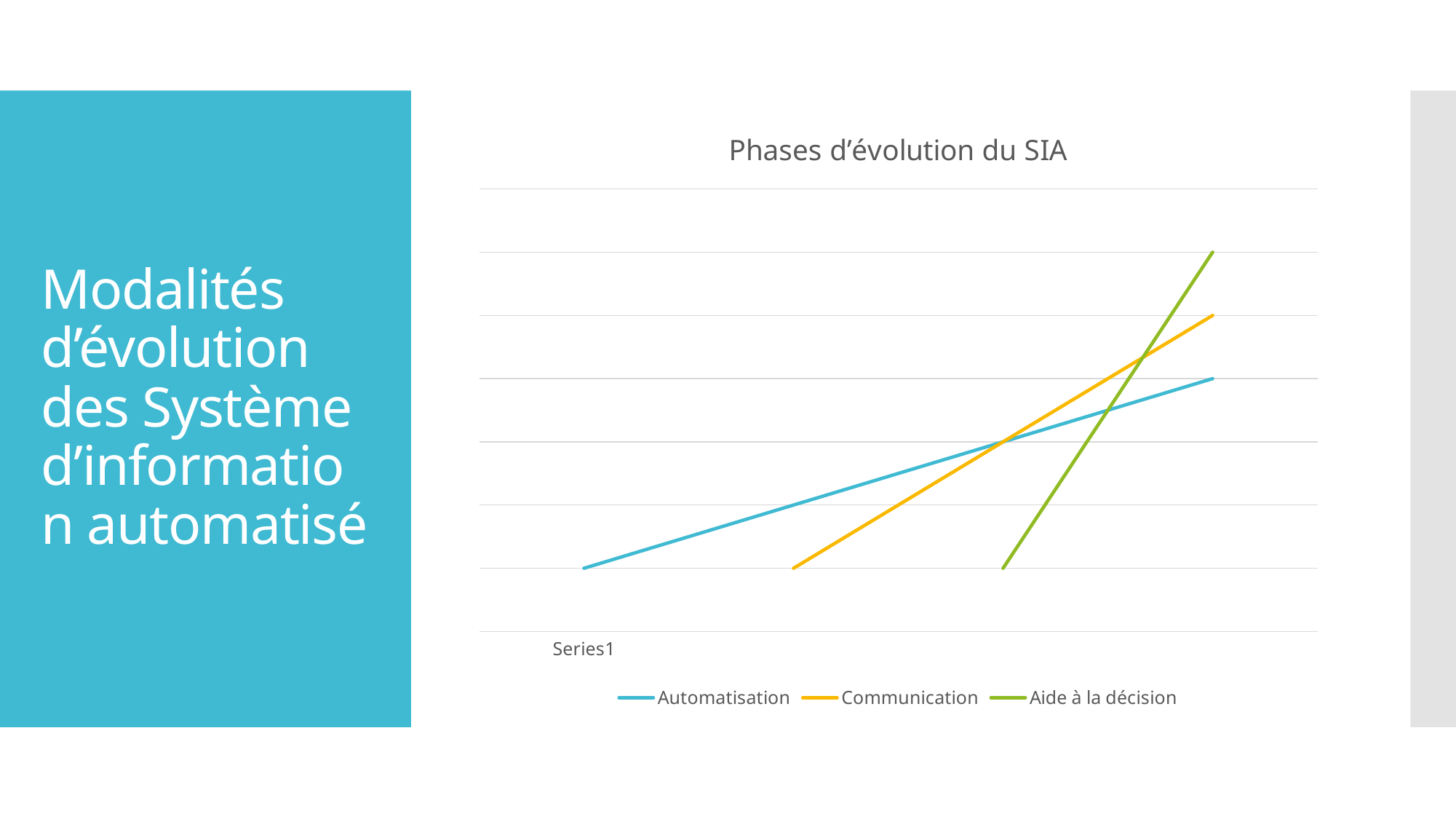
Which series is drawn in green? Aide à la décision Which series reaches the highest point on the chart? Aide à la décision Does the Aide à la décision line rise or fall from left to right? Rise Which series has the steepest line? Aide à la décision Which series ends at the lowest point on the right side of the chart? Automatisation Does the Automatisation line rise or fall from left to right? Rise Does the Communication line rise or fall from left to right? Rise How many series does the legend list? 3 What is the title of the chart? Phases d’évolution du SIA Which series starts furthest to the left on the chart? Automatisation At the right end of the chart, which line is higher: Communication or Automatisation? Communication What kind of chart is shown on the slide? Line chart